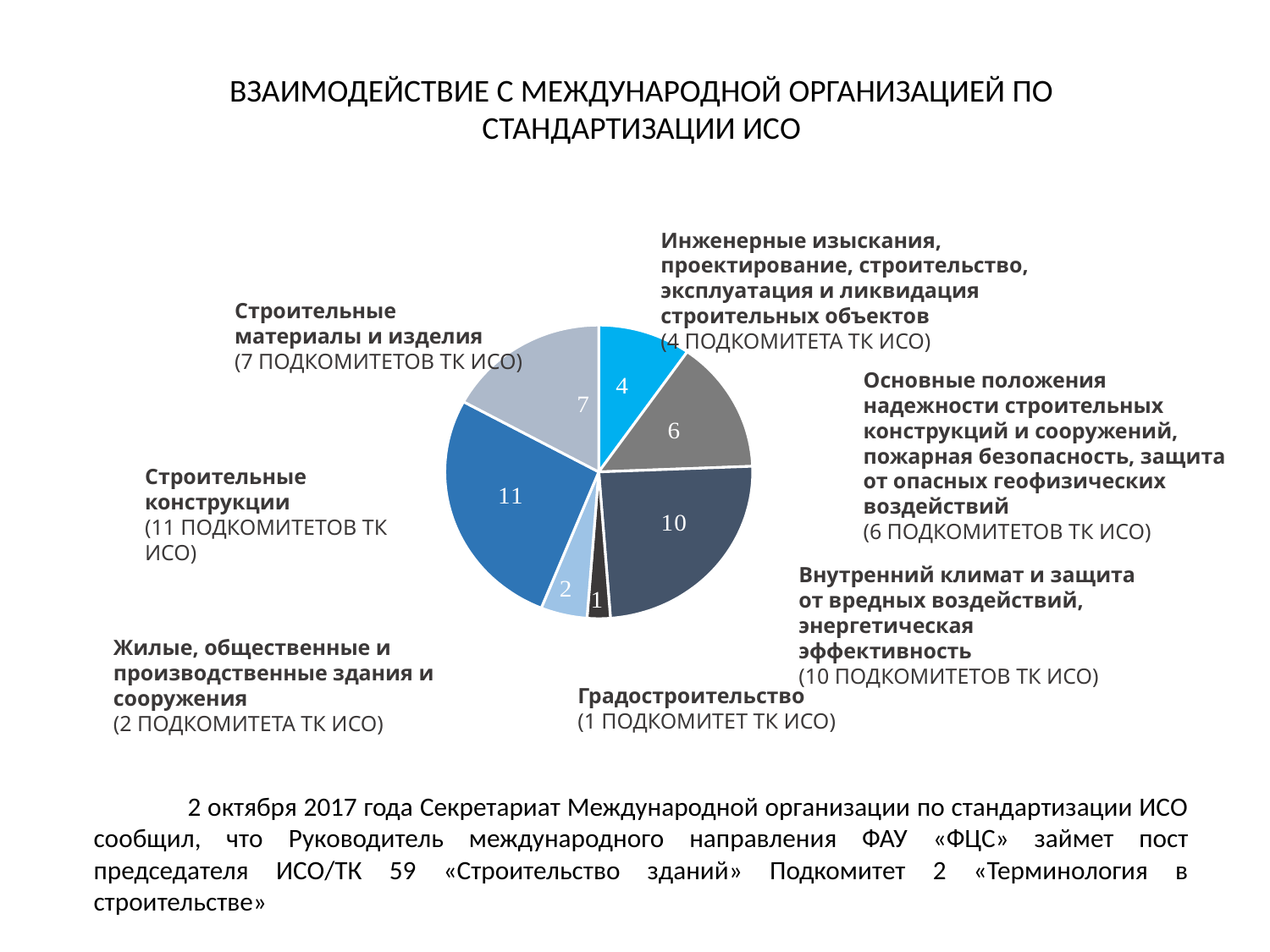
What is the title of the slide containing the pie chart? ВЗАИМОДЕЙСТВИЕ С МЕЖДУНАРОДНОЙ ОРГАНИЗАЦИЕЙ ПО СТАНДАРТИЗАЦИИ ИСО What value is shown for the slice labelled «Строительные материалы и изделия»? 7 What value is shown for the slice labelled «Внутренний климат и защита от вредных воздействий, энергетическая эффективность»? 10 How many slices does the pie chart have? 7 Which category has the smallest slice in the pie chart? Градостроительство What kind of chart is shown on the slide? Pie chart Which category has the largest slice in the pie chart? Строительные конструкции Which is larger: the value for «Основные положения надежности строительных конструкций и сооружений...» or the value for «Инженерные изыскания, проектирование, строительство...»? Основные положения надежности строительных конструкций и сооружений What value is shown for the slice labelled «Строительные конструкции»? 11 What is the total of all the values shown in the pie chart? 41 What is the difference between the values for «Строительные конструкции» and «Строительные материалы и изделия»? 4 What value is shown for the slice labelled «Градостроительство»? 1